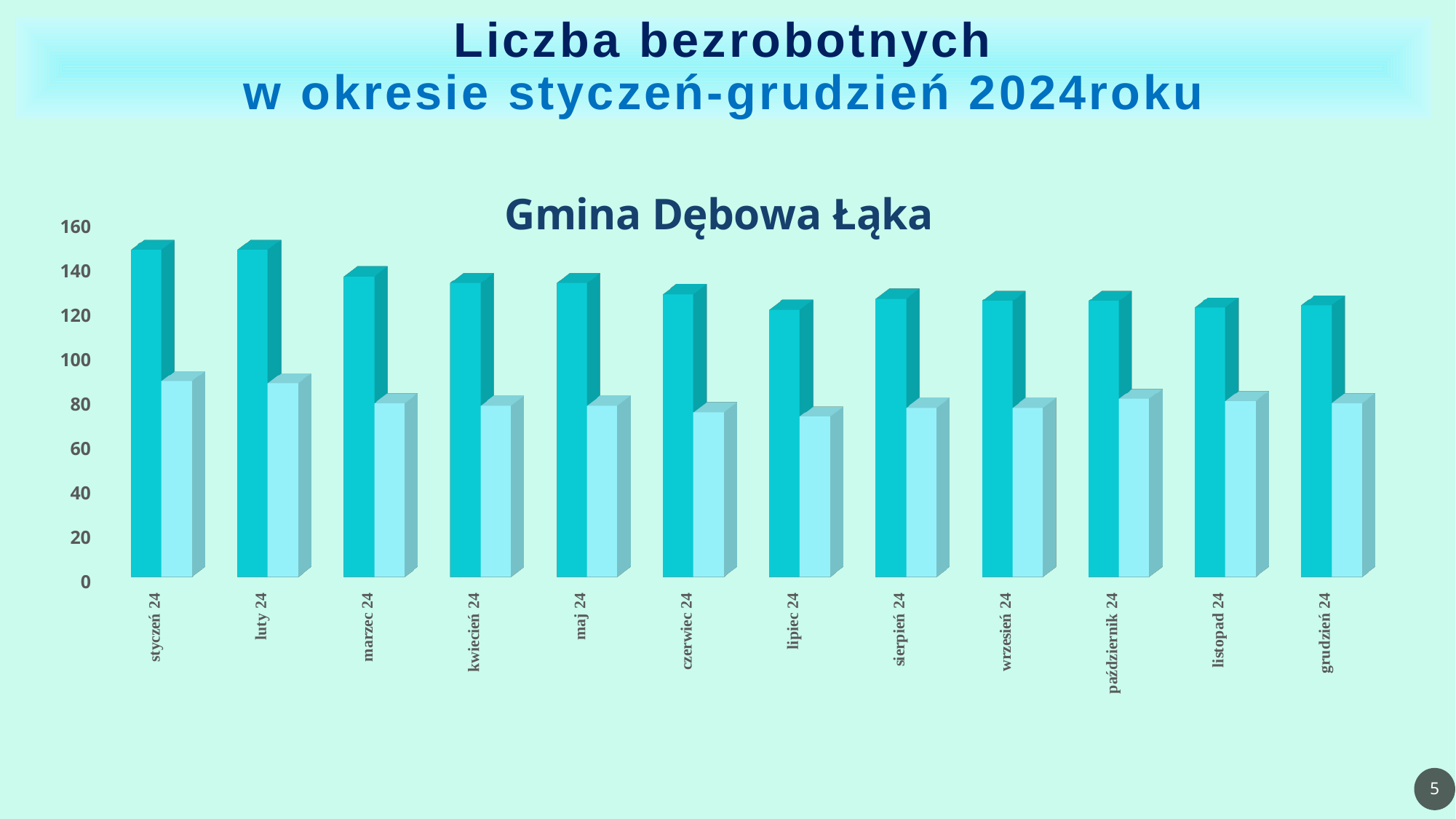
How many months (categories) are shown on the x axis of the chart? 12 Is the value of the dark teal bar for lipiec 24 greater or less than 140? less What kind of chart is shown on the slide? bar chart What is the title printed above the chart? Gmina Dębowa Łąka What is the label of the first category on the x axis? styczeń 24 Is the value of the dark teal bar for styczeń 24 greater or less than 140? greater Is the value of the light blue bar for styczeń 24 greater or less than 80? greater Which has the larger light blue bar, styczeń 24 or lipiec 24? styczeń 24 Which has the larger dark teal bar, styczeń 24 or grudzień 24? styczeń 24 Do the dark teal bars generally rise or fall from styczeń 24 to grudzień 24? fall